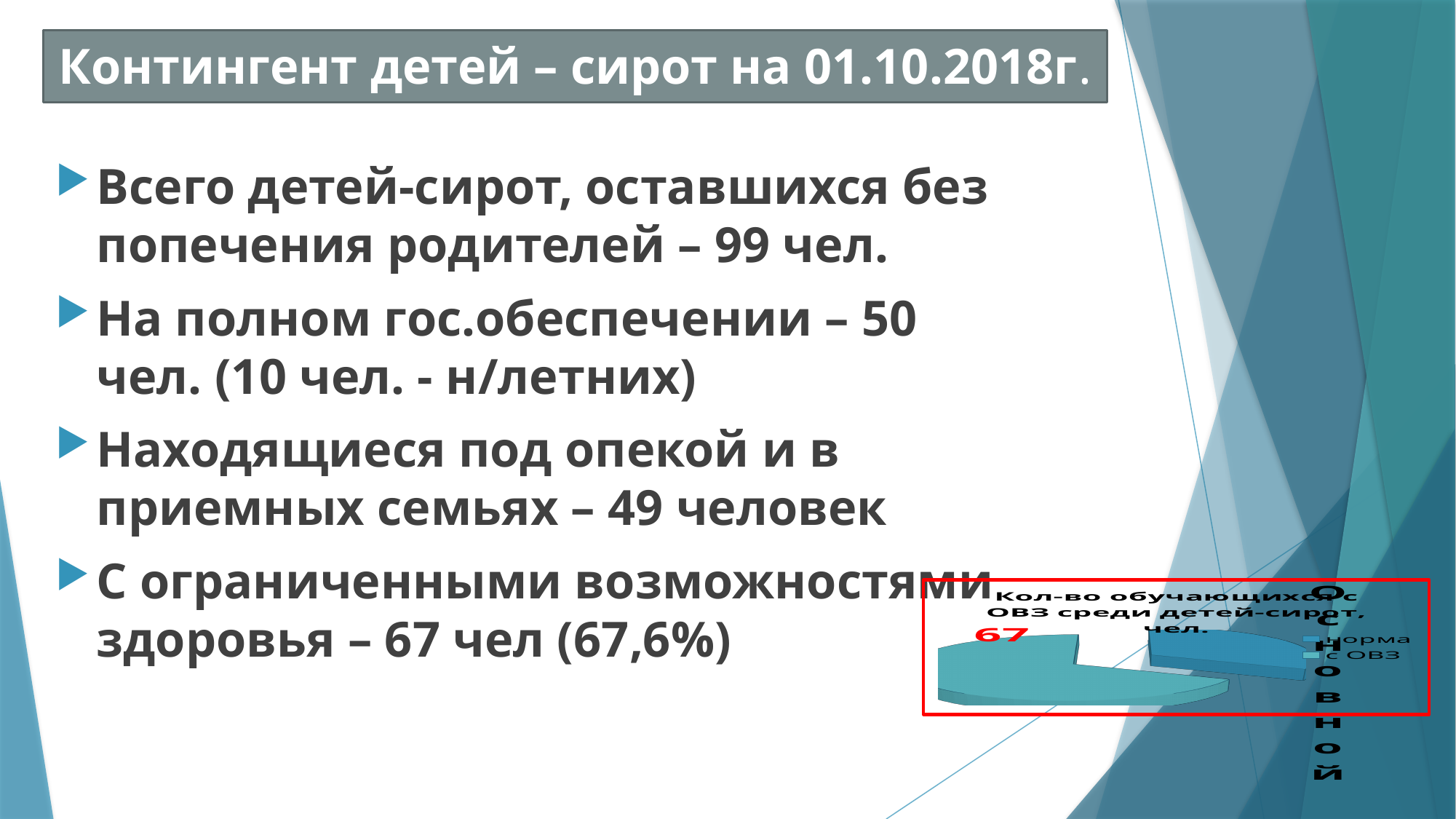
How many entries does the legend of the pie chart list? 2 What kind of chart is shown on the slide? pie chart What is the title of the pie chart? Кол-во обучающихся с ОВЗ среди детей-сирот, чел. How many slices does the pie chart have? 2 What value is printed as a data label on the pie chart? 67 What are the legend entries of the pie chart? норма, с ОВЗ